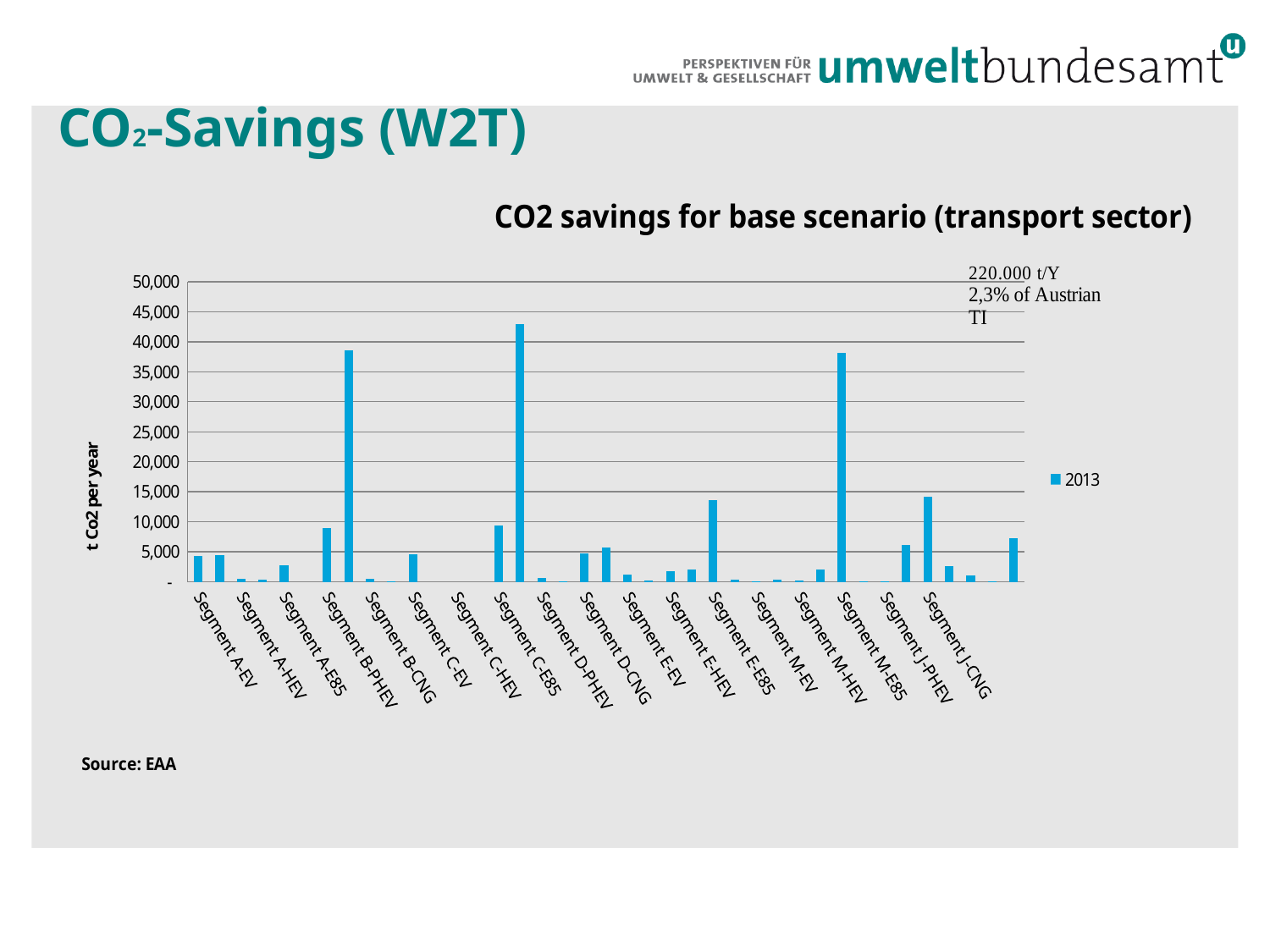
What is the title of the chart? CO2 savings for base scenario (transport sector) Is the value of the tallest bar greater or less than 40,000? greater How many series does the legend list? 1 What kind of chart is shown on the slide? bar chart What total annual savings figure is annotated on the chart? 220.000 t/Y What is the highest tick value shown on the y axis? 50,000 How many segment labels are shown on the x axis? 18 Is the value of the tallest bar greater or less than 45,000? less What percentage of Austrian TI is annotated on the chart? 2,3% What series name is shown in the legend? 2013 How many bars exceed 30,000 t CO2 per year? 3